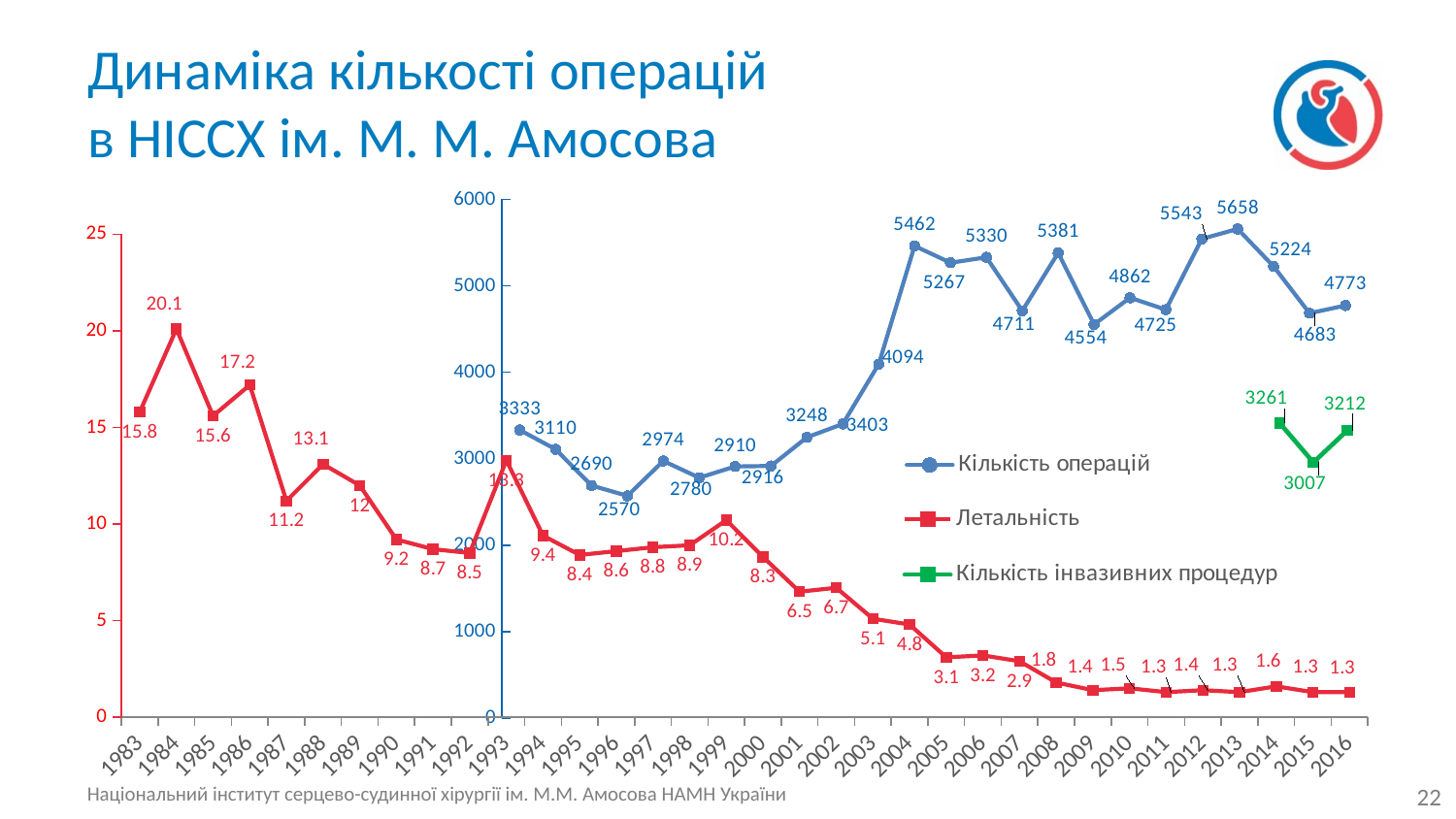
Which is larger, Кількість операцій in 2004 or in 2005? 2004 What is the value of Кількість операцій in 2013? 5658 In which year is Кількість операцій lowest? 1996 In which year is Кількість операцій highest? 2013 What type of chart is shown on the slide? line chart What is the value of Кількість інвазивних процедур in 2015? 3007 Does Летальність generally rise or fall from 1983 to 2016? fall What is the value of Летальність in 1984? 20.1 What is the difference between Кількість операцій in 2013 and in 2015? 975 In which year is Летальність highest? 1984 How many series does the legend list? 3 How many years are shown on the x axis? 34